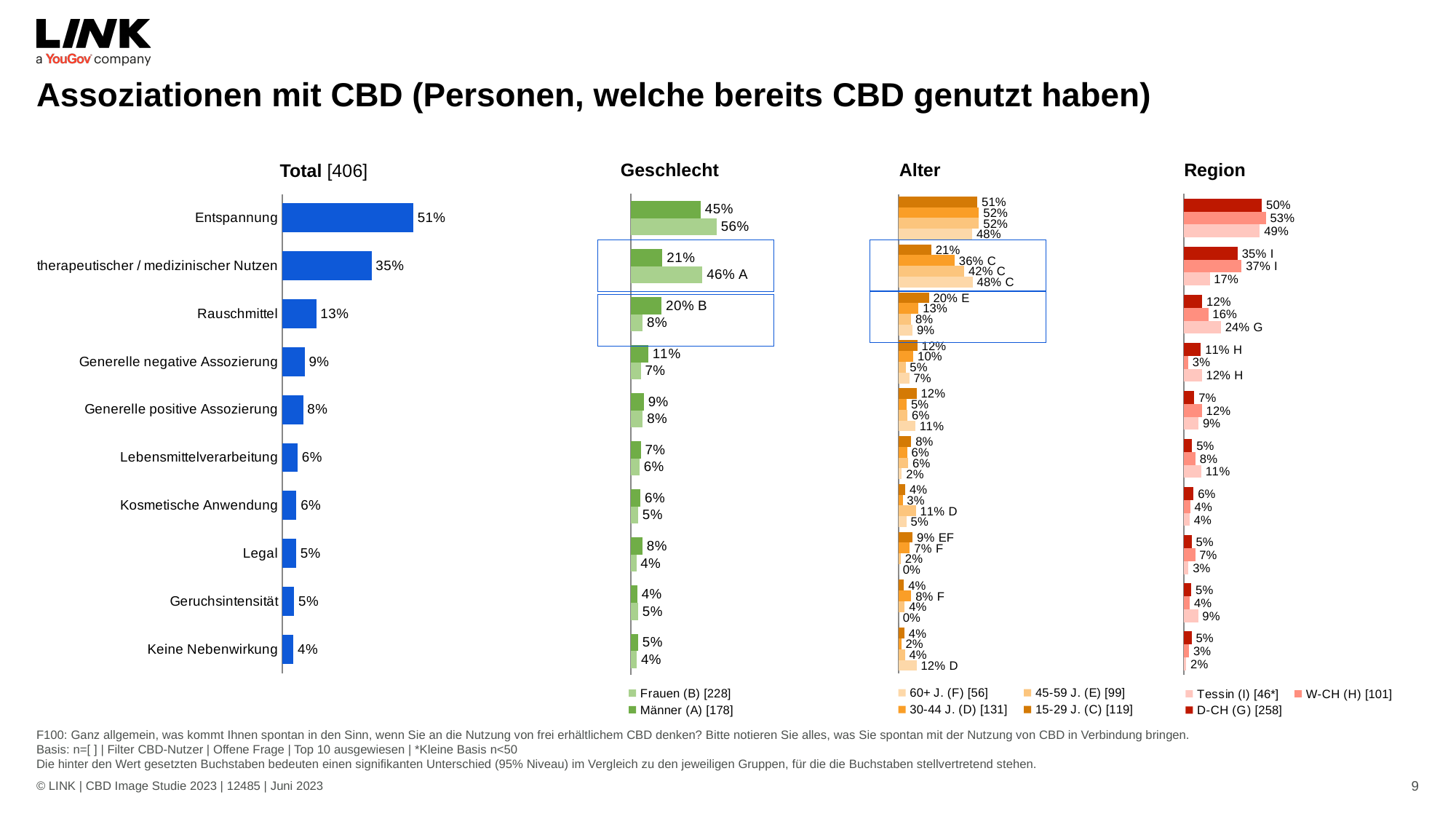
What type of chart is the Total chart? bar chart In the Total chart, what is the value for Entspannung? 51% How many categories are shown in the Total chart? 10 In the Total chart, which category has the highest value? Entspannung In the Geschlecht chart, which is larger for Rauschmittel: Männer or Frauen? Männer In the Geschlecht chart, what is the value for Frauen for Entspannung? 56% In the Total chart, what is the difference between Entspannung and Rauschmittel? 38% In the Total chart, what is the value for therapeutischer / medizinischer Nutzen? 35% What is the sample size shown next to the Total chart title? 406 In the Region chart, what is the value for Tessin (I) for Rauschmittel? 24% In the Total chart, which category has the lowest value? Keine Nebenwirkung How many series does the legend of the Alter chart list? 4